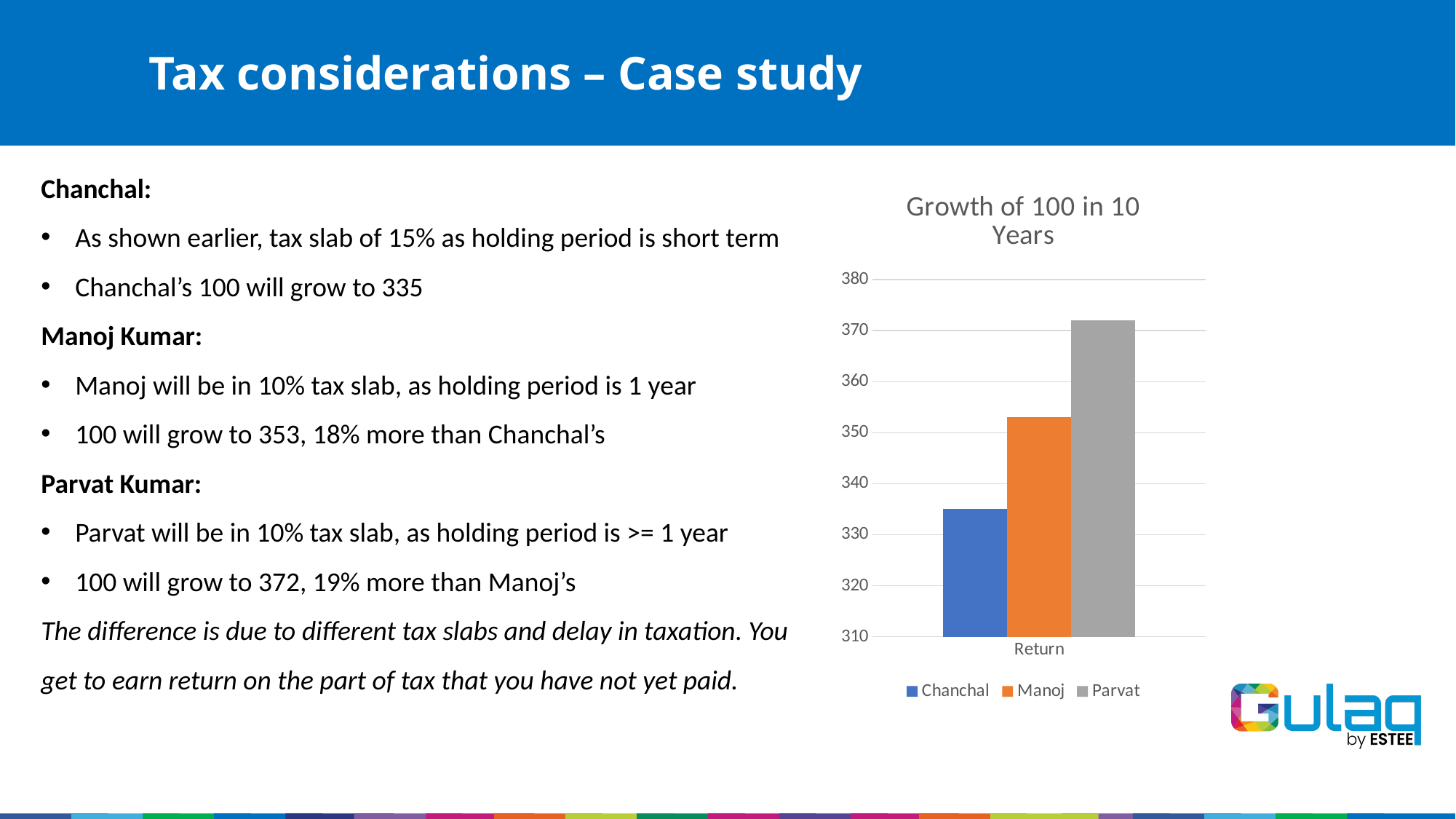
Is the value for Chanchal greater or less than 340? less Is the value for Parvat greater or less than 370? greater Which is larger in the chart, the bar for Manoj or the bar for Chanchal? Manoj Which series has the lowest bar in the chart? Chanchal Is the value for Chanchal greater or less than 330? greater How many categories are shown on the x axis of the chart? 1 What colour is the bar for Manoj in the chart? orange Which series has the highest bar in the chart? Parvat How many series does the legend of the chart list? 3 What is the title of the chart? Growth of 100 in 10 Years What kind of chart is shown on the slide? bar chart